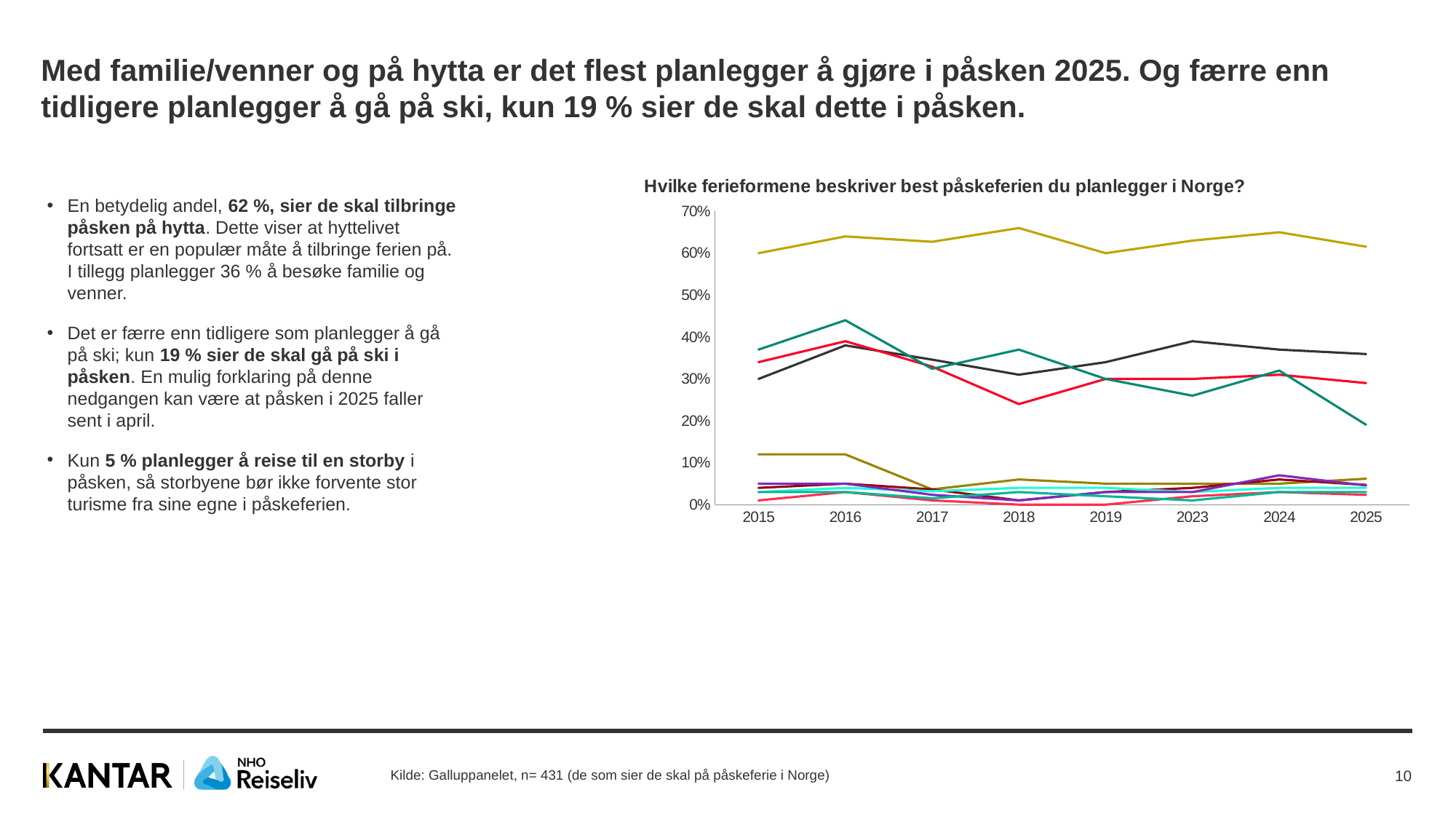
Is the value of the topmost line in 2025 greater or less than 50%? greater Are the values of the lowest cluster of lines in 2025 greater or less than 10%? less What are the first and last years shown on the x axis of the chart? 2015 and 2025 Does the topmost line rise or fall between 2019 and 2024? rise Is the value of the topmost line in 2018 greater or less than 60%? greater What kind of chart is shown on the slide? line chart What is the title of the chart? Hvilke ferieformene beskriver best påskeferien du planlegger i Norge? How many years are shown on the x axis of the chart? 8 Does the topmost line rise or fall between 2024 and 2025? fall